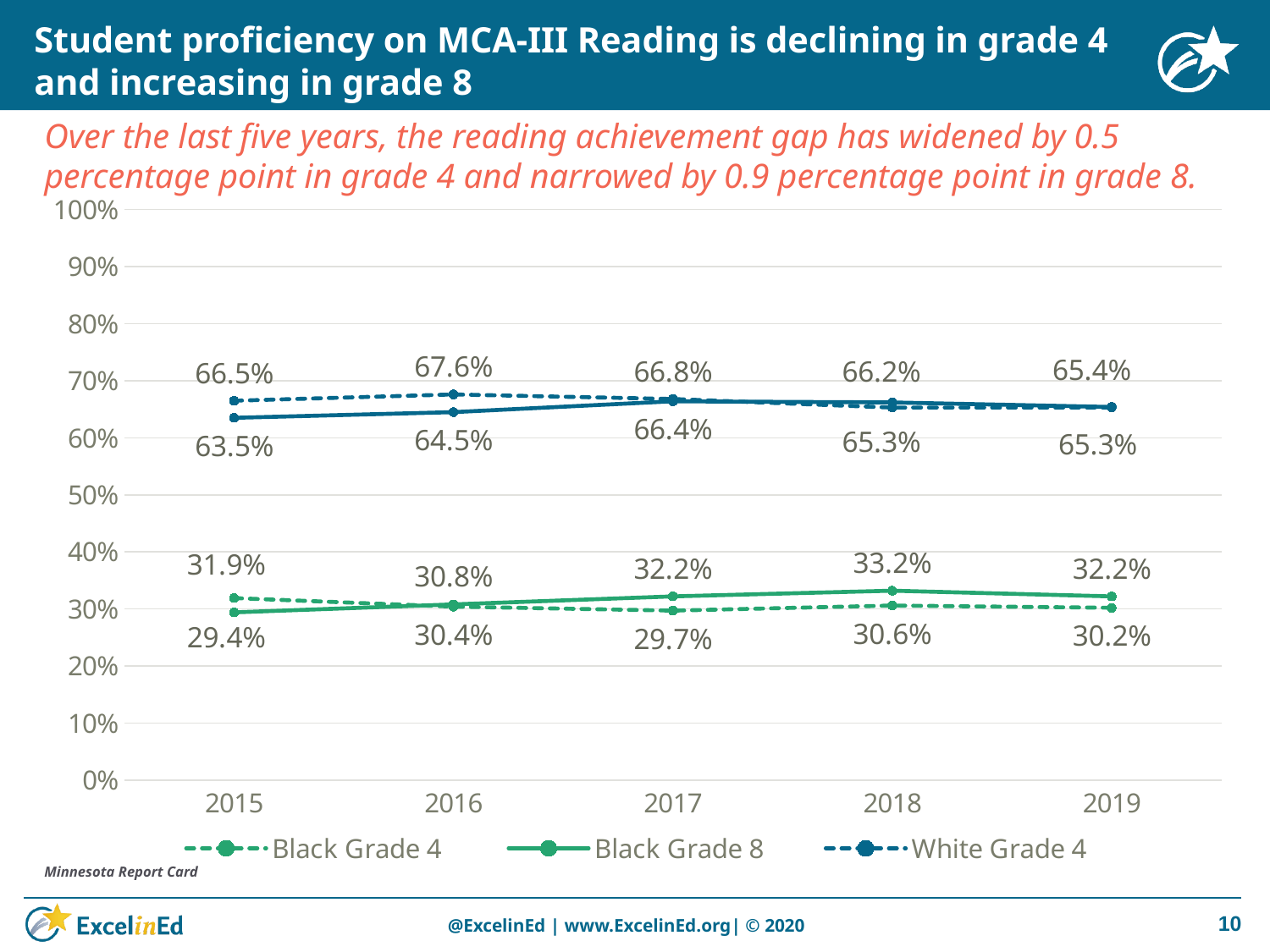
Is the Black Grade 8 proficiency rate in 2018 greater or less than 30%? greater What is the difference between the White Grade 4 and Black Grade 4 proficiency rates in 2019? 35.1 percentage points Which was higher in 2017: the Black Grade 8 rate or the Black Grade 4 rate? Black Grade 8 What type of chart is shown on the slide? line chart What was the reading proficiency rate for White Grade 4 students in 2016? 67.6% What was the reading proficiency rate for White Grade 4 students in 2019? 65.3% What was the reading proficiency rate for Black Grade 4 students in 2015? 31.9% How many years are shown on the x axis? 5 In which year was the White Grade 4 proficiency rate highest? 2016 Does the White Grade 4 proficiency rate rise or fall from 2016 to 2019? fall In which year was the Black Grade 8 proficiency rate lowest? 2015 What was the reading proficiency rate for Black Grade 8 students in 2018? 33.2%